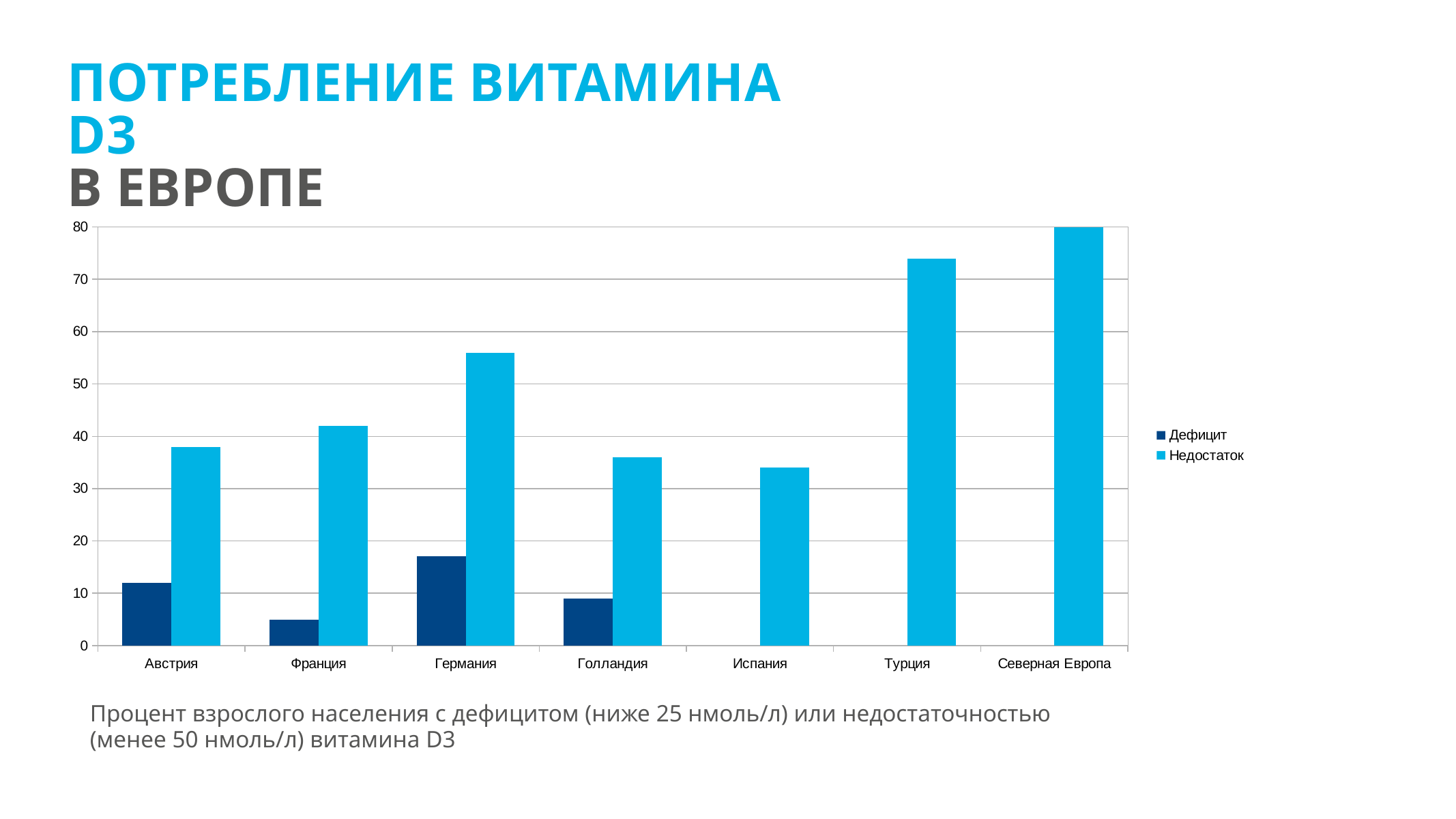
What is the value of Недостаток for Северная Европа? 80 Is the Недостаток value for Германия greater or less than 50? greater Is the Дефицит value for Франция greater or less than 10? less How many countries/regions are shown on the x axis of the chart? 7 Which category has the highest Дефицит value? Германия Is the Недостаток value for Турция greater or less than 70? greater What kind of chart is shown on the slide? bar chart How many series does the chart legend list? 2 What are the two series named in the chart legend? Дефицит and Недостаток Which category has the highest Недостаток value? Северная Европа Which is larger, the Недостаток value for Германия or for Франция? Германия